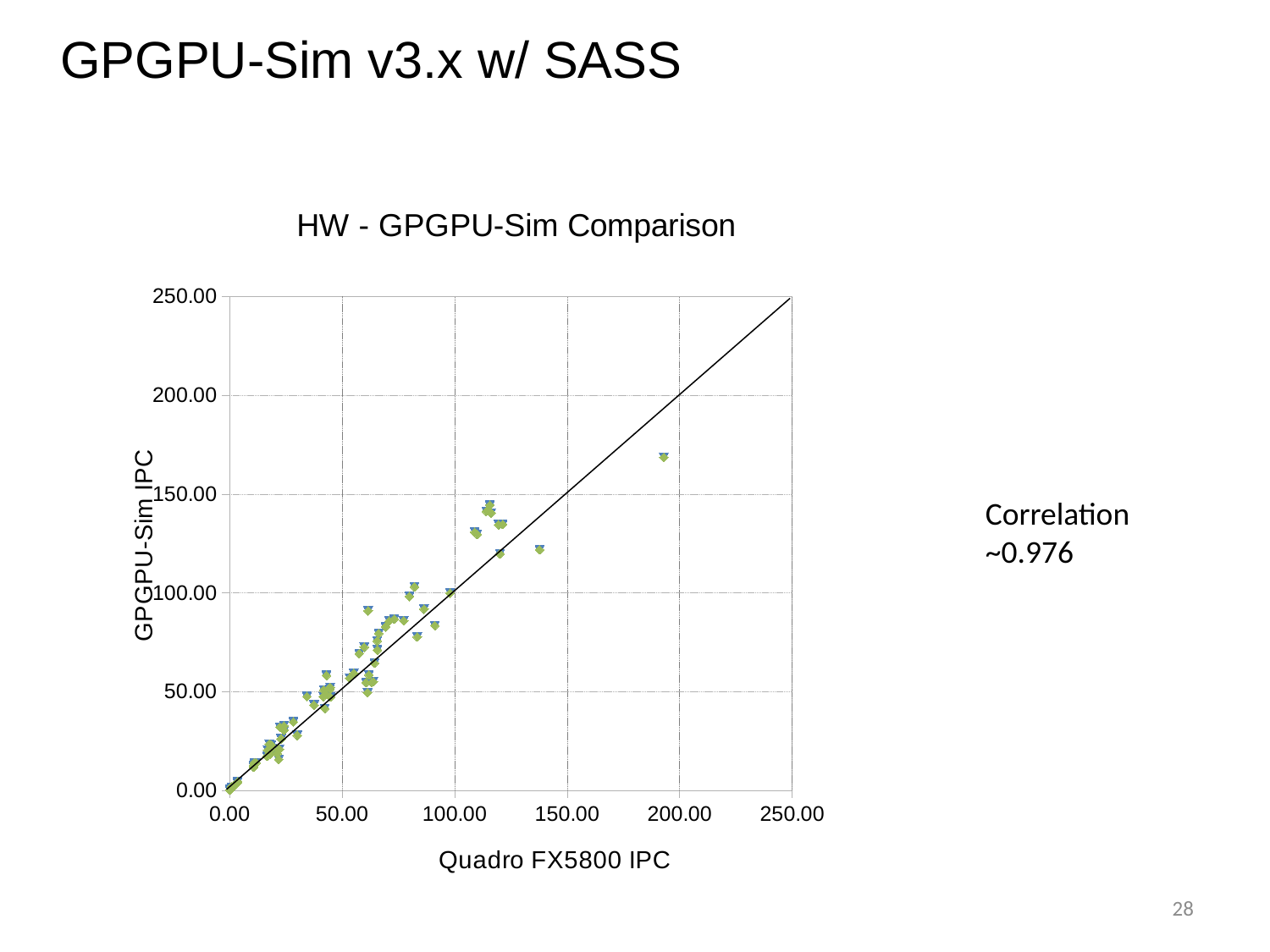
What is the label of the x axis of the chart? Quadro FX5800 IPC Is the Quadro FX5800 IPC value of the rightmost point greater or less than 150? greater As Quadro FX5800 IPC increases along the x axis, does GPGPU-Sim IPC generally rise or fall? rise Is the rightmost point above or below the diagonal line? below What is the title of the chart? HW - GPGPU-Sim Comparison Is the Quadro FX5800 IPC value of the rightmost point greater or less than 200? less Is the GPGPU-Sim IPC value of the point with the highest Quadro FX5800 IPC greater or less than 150? greater What kind of chart is shown on the slide? scatter chart